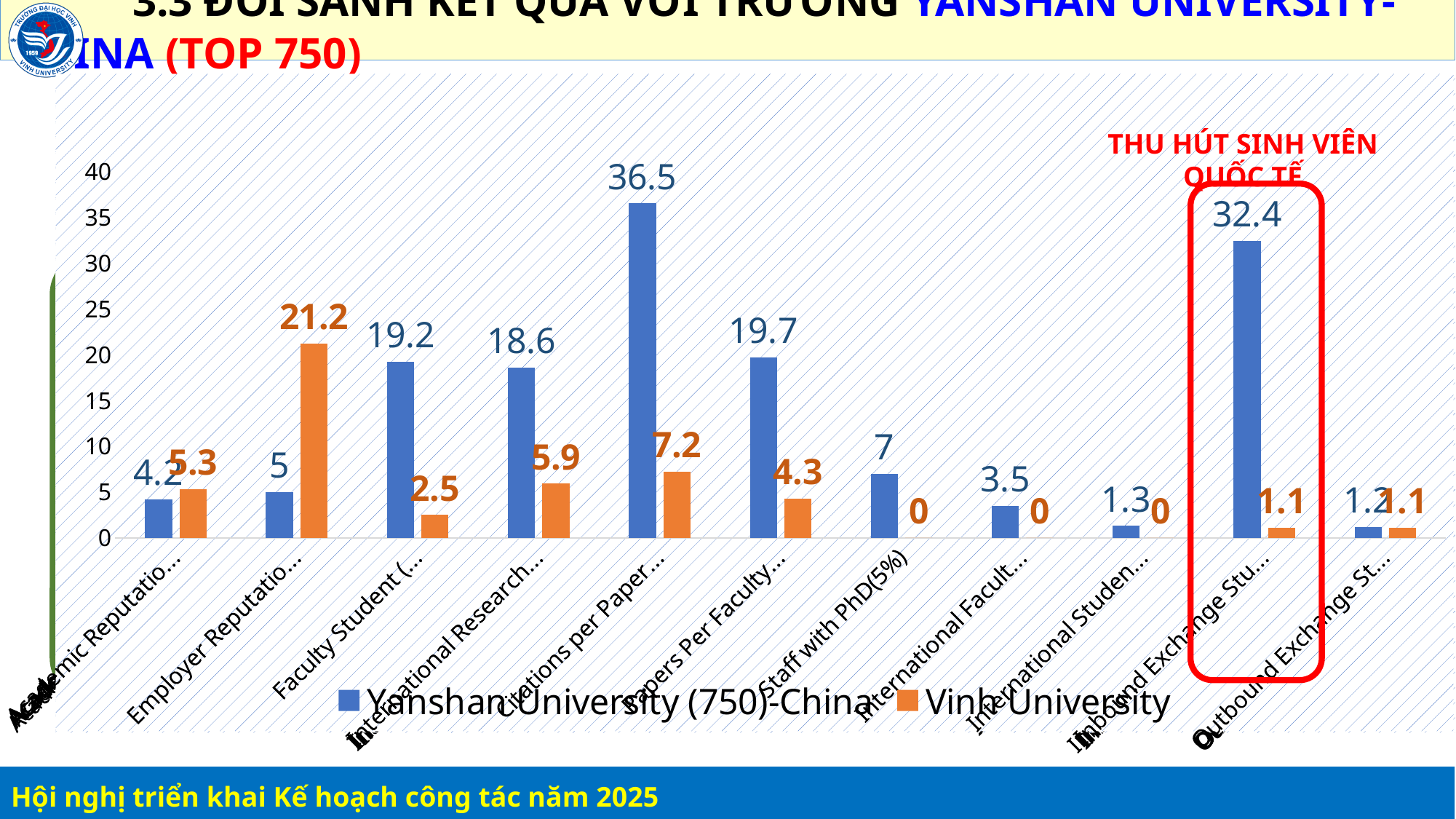
What is the value for Vinh University in the Employer Reputation category? 21.2 What is the value for Yanshan University (750)-China in the Staff with PhD(5%) category? 7 Which series is shown in orange in the legend? Vinh University What is the difference between Yanshan University (750)-China and Vinh University in the Inbound Exchange Students category? 31.3 How many categories are plotted along the x axis? 11 What is the value for Yanshan University (750)-China in the Citations per Paper category? 36.5 In which category does Yanshan University (750)-China have its highest value? Citations per Paper What type of chart is shown on the slide? bar chart How many series does the legend list? 2 In which category does Vinh University have its highest value? Employer Reputation Which is larger in the Academic Reputation category: Yanshan University (750)-China or Vinh University? Vinh University What is the value for Vinh University in the Staff with PhD(5%) category? 0